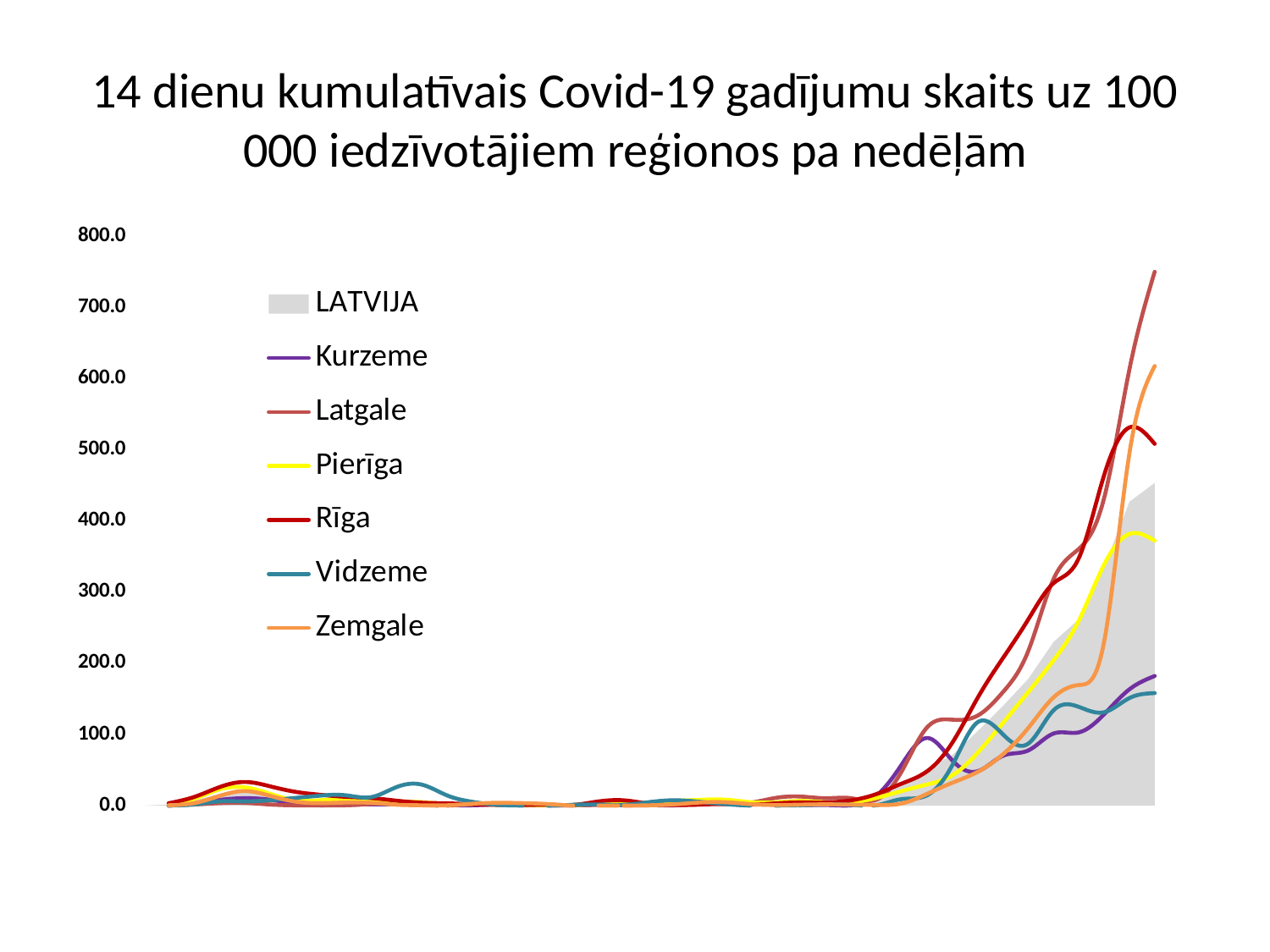
Is the final value for Latgale greater or less than 700? greater At the right end of the chart, which is larger: Latgale or Zemgale? Latgale At the right end of the chart, which is larger: Rīga or Pierīga? Rīga Is the final value for Zemgale greater or less than 500? greater What kind of chart is shown on the slide? combination area and line chart Do the values generally rise or fall toward the right end of the chart? rise Is the final value for Pierīga greater or less than 400? less Which legend entry is shown as a shaded grey area rather than a line? LATVIJA Which series reaches the highest value at the right end of the chart? Latgale How many series does the legend list? 7